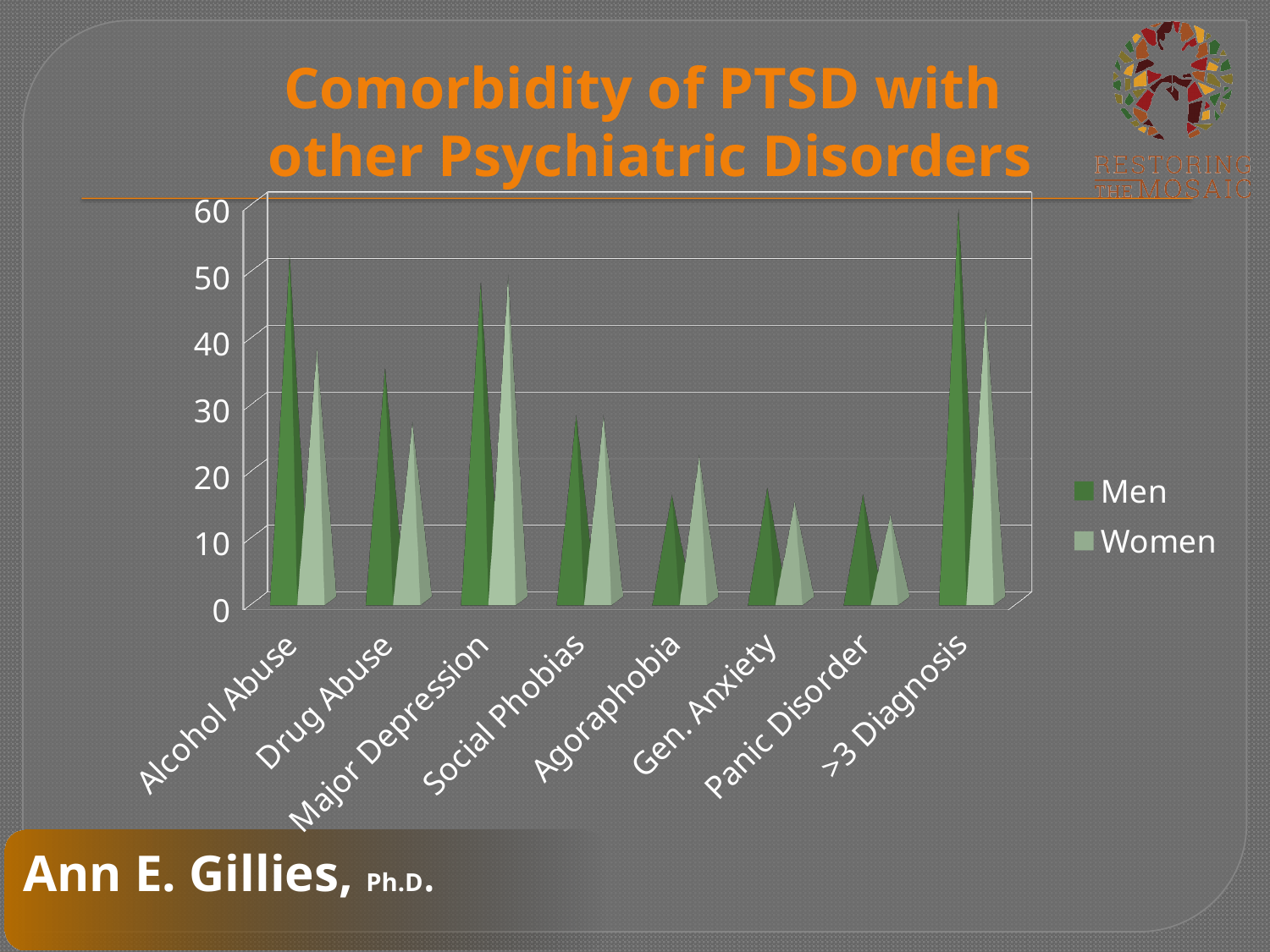
For Alcohol Abuse, which is larger: the value for Men or the value for Women? Men What is the title of the chart? Comorbidity of PTSD with other Psychiatric Disorders Is the value for Men in Alcohol Abuse greater or less than 40? greater Is the value for Men in Drug Abuse greater or less than 20? greater For Agoraphobia, which is larger: the value for Men or the value for Women? Women How many series does the chart's legend list? 2 Is the value for Women in Panic Disorder greater or less than 20? less What kind of chart is shown on the slide? bar chart How many categories are shown along the x axis of the chart? 8 Which category has the highest value for Men? >3 Diagnosis